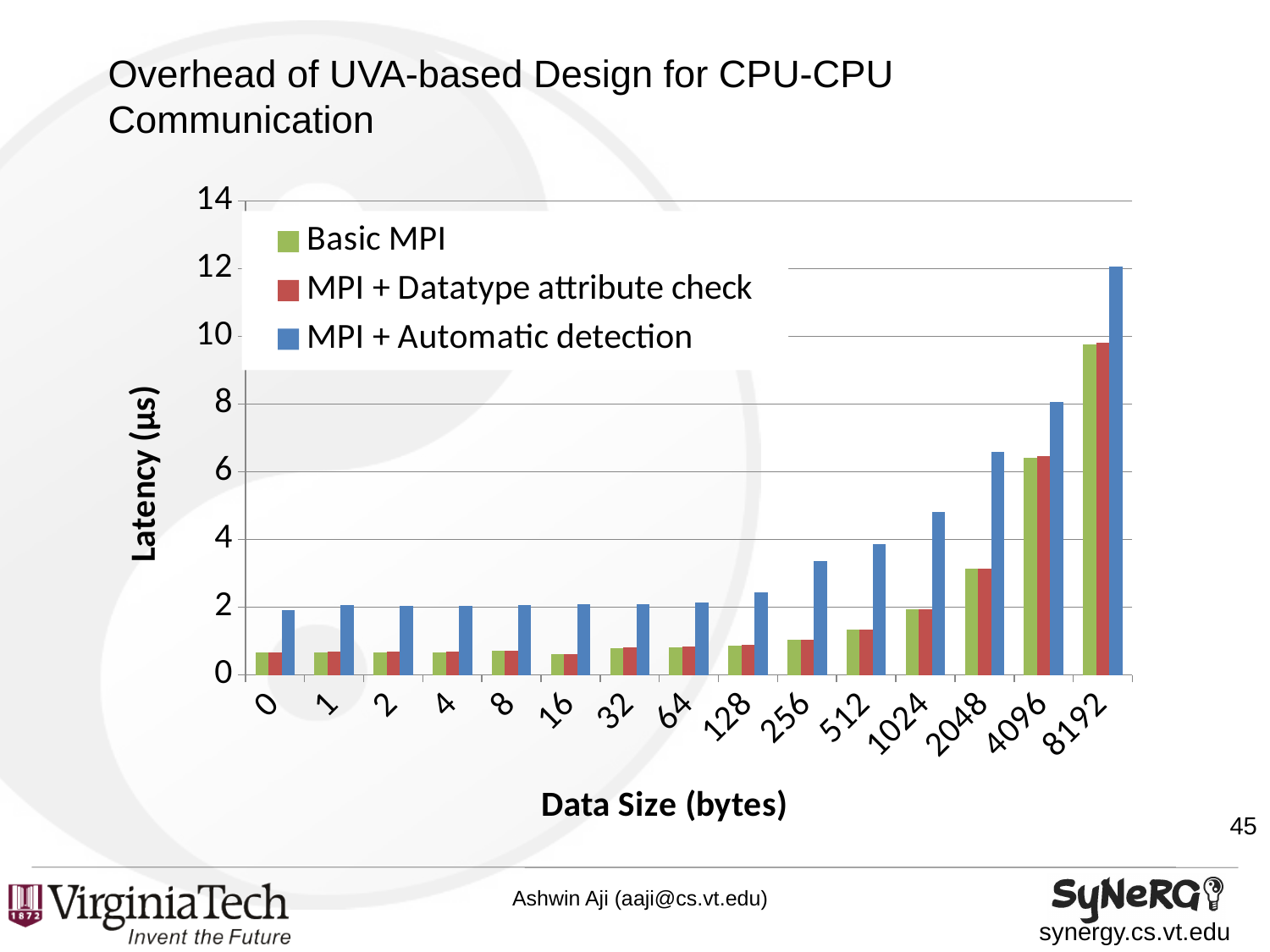
Is the latency for MPI + Automatic detection at 8192 bytes greater or less than 10? greater At 8192 bytes, which is larger: the latency for MPI + Automatic detection or for Basic MPI? MPI + Automatic detection Is the latency for MPI + Automatic detection at 2048 bytes greater or less than 6? greater How many data size categories are shown on the x axis? 15 What type of chart is shown on the slide? bar chart Does the latency for MPI + Automatic detection rise or fall as data size increases along the x axis? rise What is the label of the y axis? Latency (µs) Is the latency for Basic MPI at 8192 bytes greater or less than 10? less Which data size has the highest latency for MPI + Automatic detection? 8192 How many series does the legend list? 3 What is the label of the x axis? Data Size (bytes)